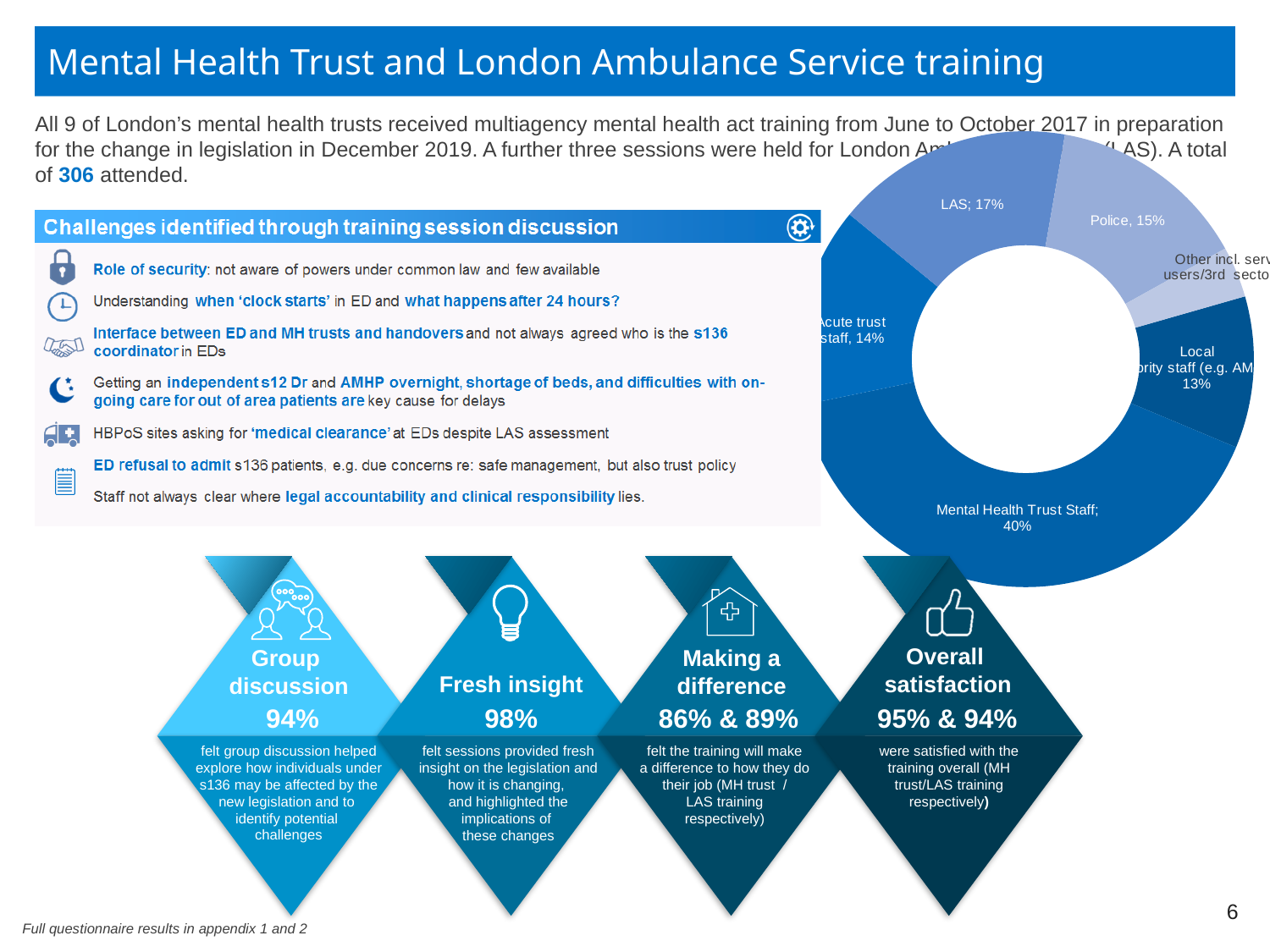
In the doughnut chart, is the Mental Health Trust Staff share greater or less than 30%? greater What kind of chart is shown on the right of the slide? doughnut chart In the doughnut chart, which is larger: the LAS slice or the Police slice? LAS Which category has the largest slice in the doughnut chart? Mental Health Trust Staff In the doughnut chart, what percentage is shown for LAS? 17% How many slices does the doughnut chart have? 6 In the doughnut chart, what is the difference in percentage points between Police and Local security staff? 2 In the doughnut chart, what percentage is shown for Acute trust staff? 14% In the doughnut chart, what percentage is shown for Local security staff? 13% In the doughnut chart, what share of attendees were Mental Health Trust Staff? 40% In the doughnut chart, what is the difference in percentage points between Mental Health Trust Staff and LAS? 23 In the doughnut chart, what percentage is shown for Police? 15%